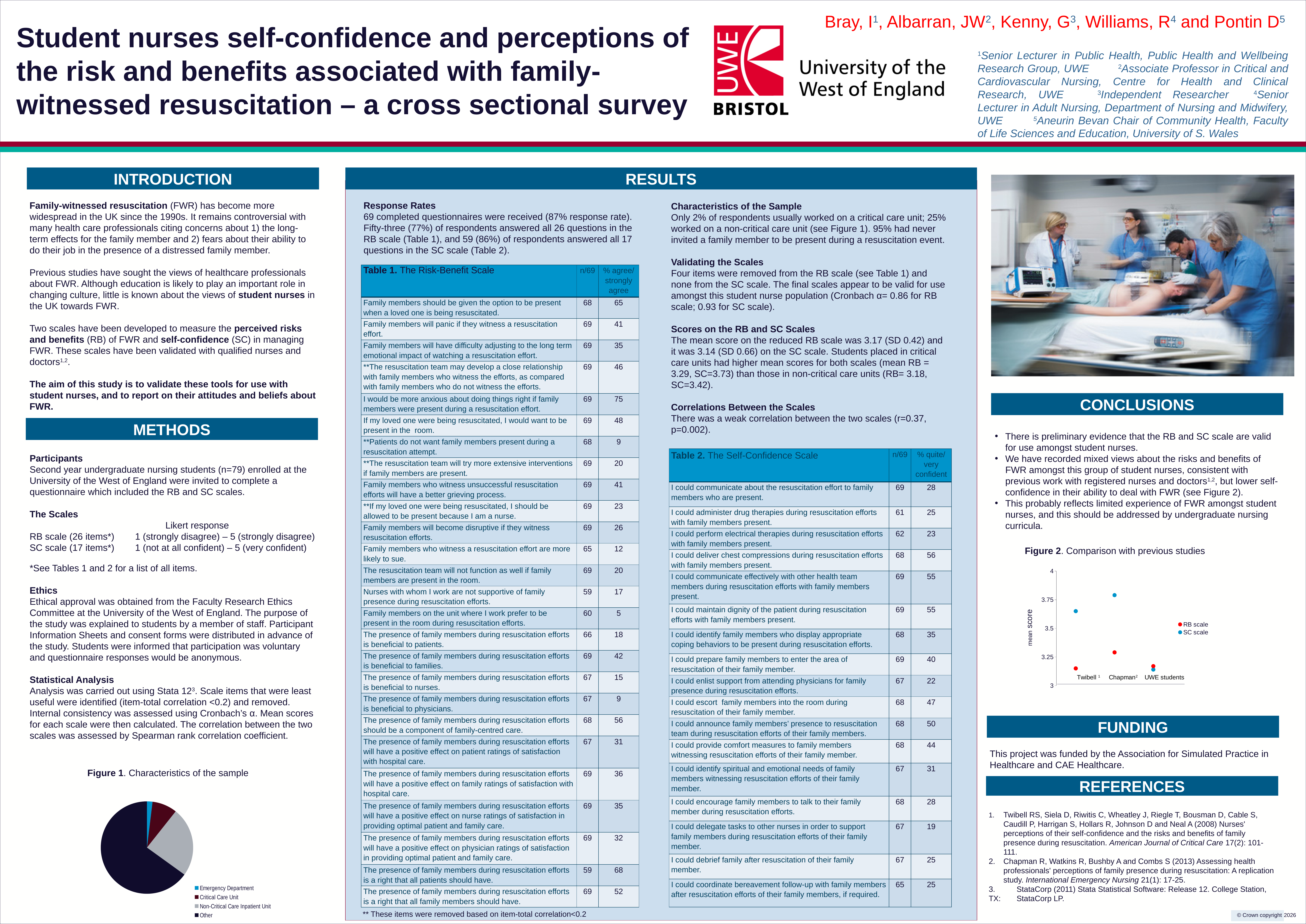
In Figure 2, Comparison with previous studies, what is the label of the y axis? mean score In Figure 2, Comparison with previous studies, which is larger for Twibell: the RB scale or the SC scale? SC scale In Figure 2, Comparison with previous studies, is the SC scale value for Chapman greater or less than 3.5? greater In Figure 2, Comparison with previous studies, is the SC scale value for UWE students greater or less than 3.25? less In Figure 1, Characteristics of the sample, which category has the smallest slice? Emergency Department In Figure 2, Comparison with previous studies, is the RB scale value for Twibell greater or less than 3.25? less In Figure 2, Comparison with previous studies, how many studies are shown on the x axis? 3 In Figure 2, Comparison with previous studies, which study has the highest SC scale mean score? Chapman What kind of chart is Figure 1, Characteristics of the sample? pie chart In Figure 1, Characteristics of the sample, how many categories does the legend list? 4 In Figure 1, Characteristics of the sample, which category has the largest slice? Other In Figure 2, Comparison with previous studies, how many series does the legend list? 2